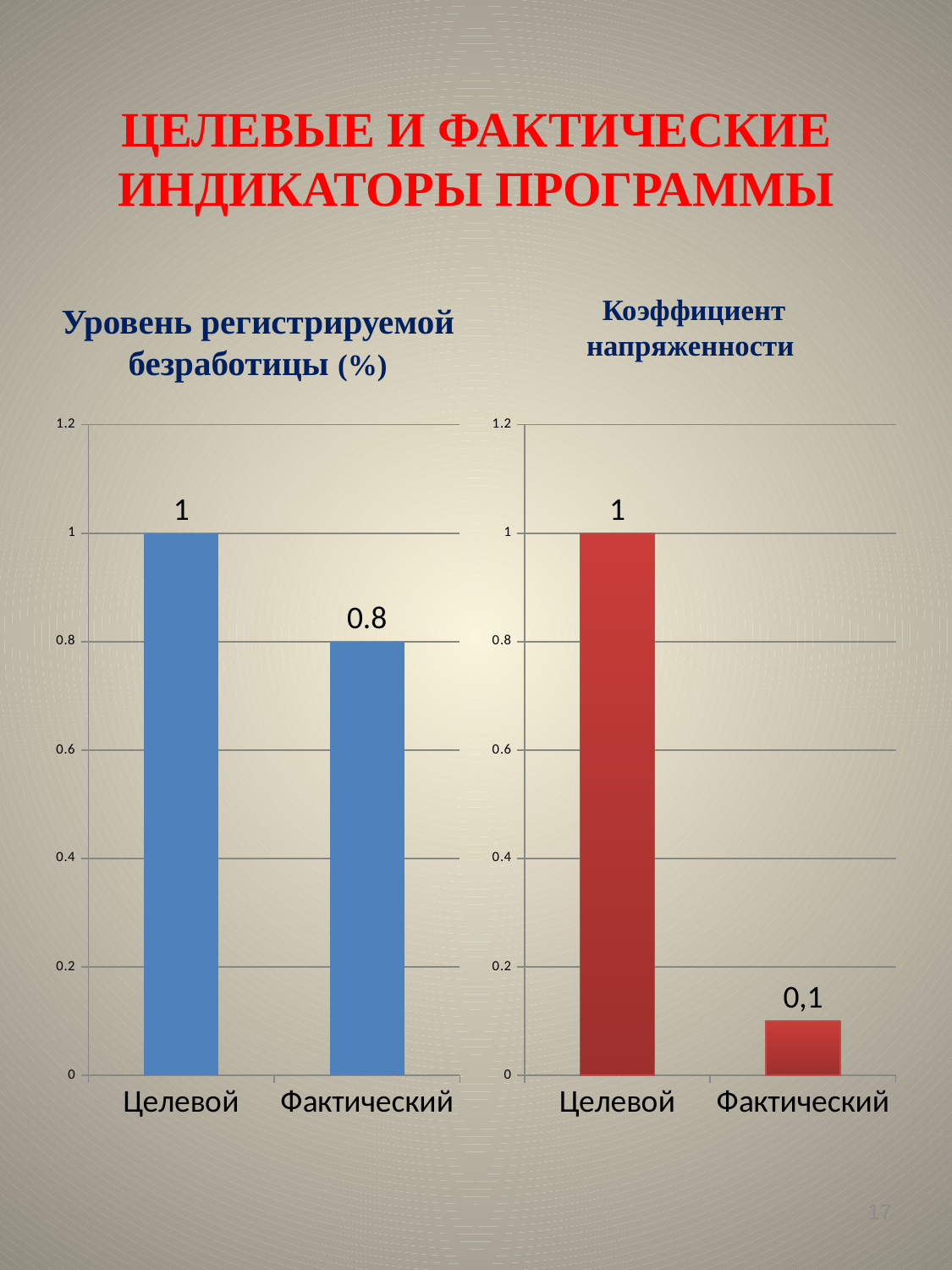
In the right chart (Коэффициент напряженности), what is the value for Фактический? 0,1 In the left chart (Уровень регистрируемой безработицы (%)), what is the value for Целевой? 1 In the right chart (Коэффициент напряженности), what is the difference between the Целевой and Фактический values? 0,9 What kind of chart is the right chart (Коэффициент напряженности)? Bar chart In the right chart (Коэффициент напряженности), which category has the highest value? Целевой In the left chart (Уровень регистрируемой безработицы (%)), which category has the lowest value? Фактический In the left chart (Уровень регистрируемой безработицы (%)), what is the value for Фактический? 0.8 How many categories are shown in the left chart (Уровень регистрируемой безработицы (%))? 2 In the right chart (Коэффициент напряженности), which is larger: Целевой or Фактический? Целевой In the right chart (Коэффициент напряженности), what is the value for Целевой? 1 In the left chart (Уровень регистрируемой безработицы (%)), what is the difference between the Целевой and Фактический values? 0.2 What colour are the bars in the left chart (Уровень регистрируемой безработицы (%))? Blue